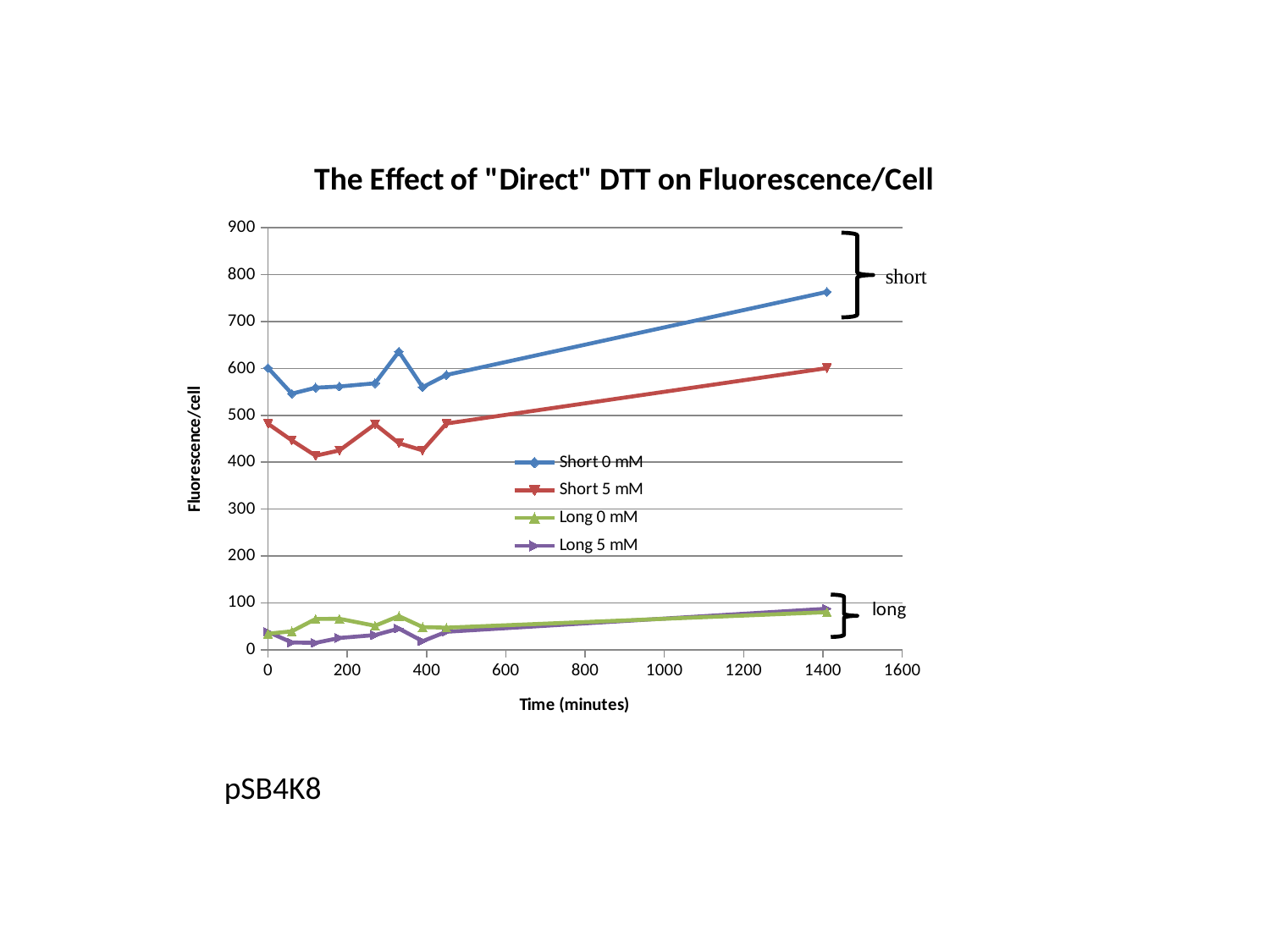
Does the Short 5 mM series rise or fall between about 450 minutes and about 1400 minutes? rise Is the peak value of Short 0 mM near 330 minutes greater or less than 600? greater What is the title of the chart? The Effect of "Direct" DTT on Fluorescence/Cell Which series reaches the lowest value on the chart? Long 5 mM At the final time point (about 1400 minutes), which is larger: Short 0 mM or Short 5 mM? Short 0 mM Is the value for Short 5 mM at about 120 minutes greater or less than 500? less Is the value for Long 0 mM at the final time point (about 1400 minutes) greater or less than 100? less How many series does the legend list? 4 Which series has the highest value at the final time point (about 1400 minutes)? Short 0 mM What is the label of the x axis? Time (minutes) What kind of chart is shown on the slide? line chart